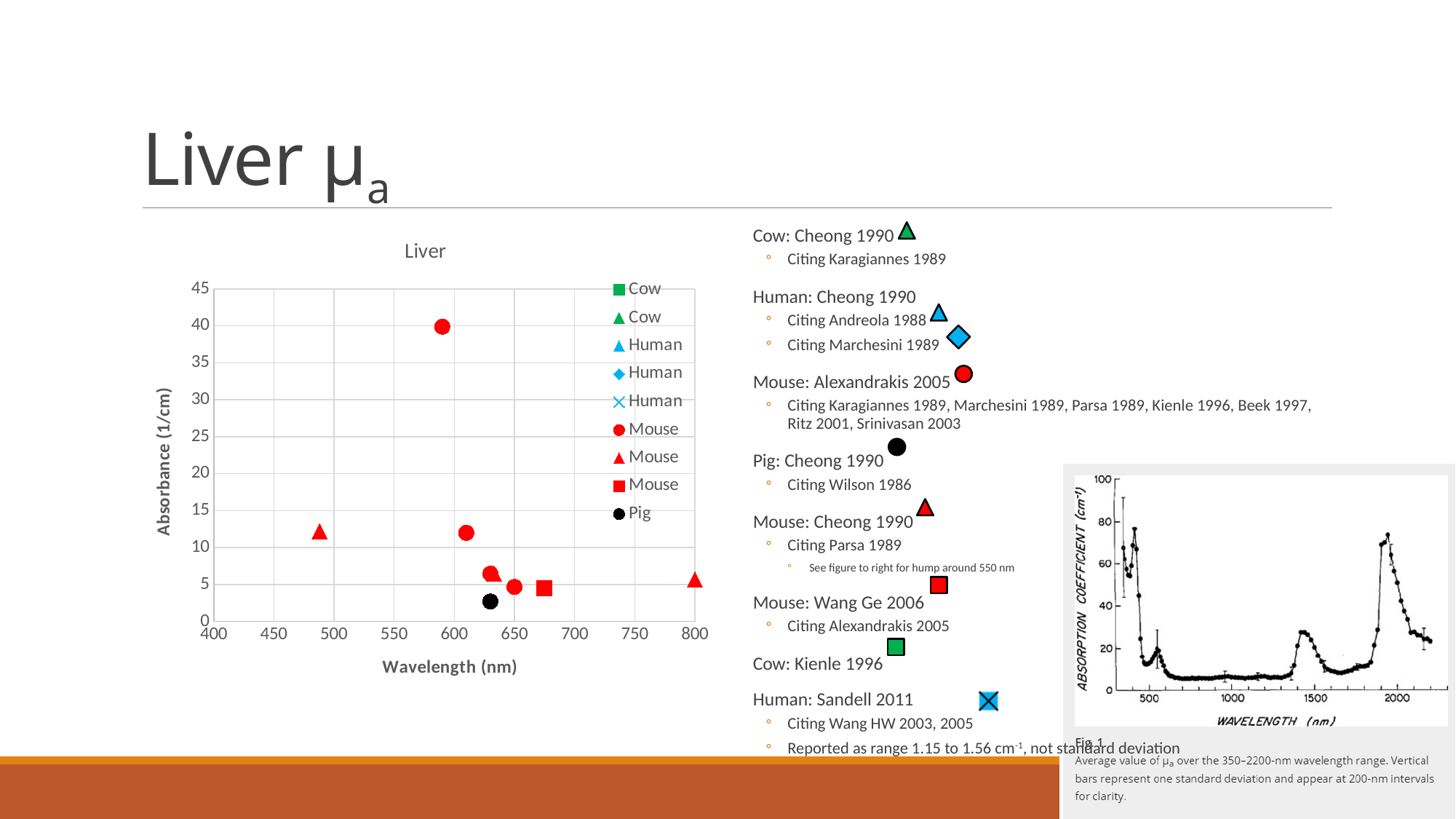
In the 'Liver' chart, which animal's series has the highest plotted absorbance value? Mouse In the 'Liver' chart, is the absorbance of the Mouse (red triangle) point near 490 nm greater or less than 10? greater In the 'Liver' chart, is the absorbance of the Mouse (red square) point near 675 nm greater or less than 10? less In the 'Liver' chart, do the Mouse (red circle) points rise or fall as wavelength increases? fall In the 'Liver' chart, is the absorbance of the highest Mouse (red circle) point, near 590 nm, greater or less than 35? greater What is the title of the y axis of the 'Liver' chart? Absorbance (1/cm) What is the title of the x axis of the 'Liver' chart? Wavelength (nm) In the 'Liver' chart, which series has the lowest plotted absorbance value? Pig In the 'Liver' chart, which has the higher absorbance: the Mouse (red circle) point near 590 nm or the Mouse (red triangle) point at 800 nm? the Mouse (red circle) point near 590 nm How many series does the legend of the 'Liver' chart list? 9 What kind of chart is the 'Liver' chart on the left of the slide? scatter chart